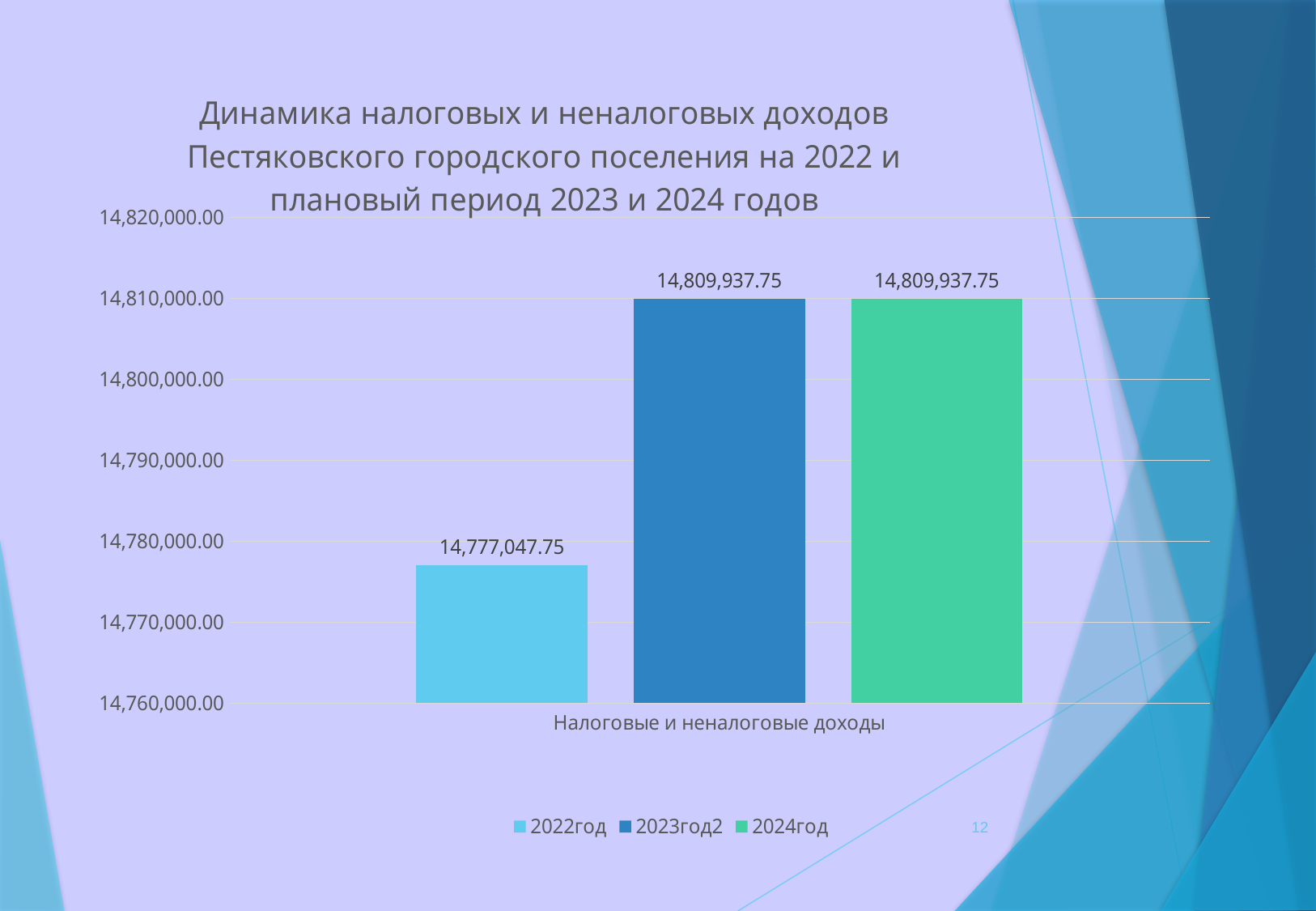
How many series does the legend list? 3 What is the value for the 2022год series? 14,777,047.75 What kind of chart is shown on the slide? bar chart Which is larger, the value for 2022год or the value for 2024год? 2024год Is the value for 2022год greater or less than 14,780,000.00? less What is the difference between the 2023год2 value and the 2022год value? 32,890.00 Which series has the lowest value? 2022год What is the value for the 2023год2 series? 14,809,937.75 What colour is the bar for the 2024год series? green What is the value for the 2024год series? 14,809,937.75 What is the category label on the x axis? Налоговые и неналоговые доходы Is the value for 2024год greater or less than 14,800,000.00? greater